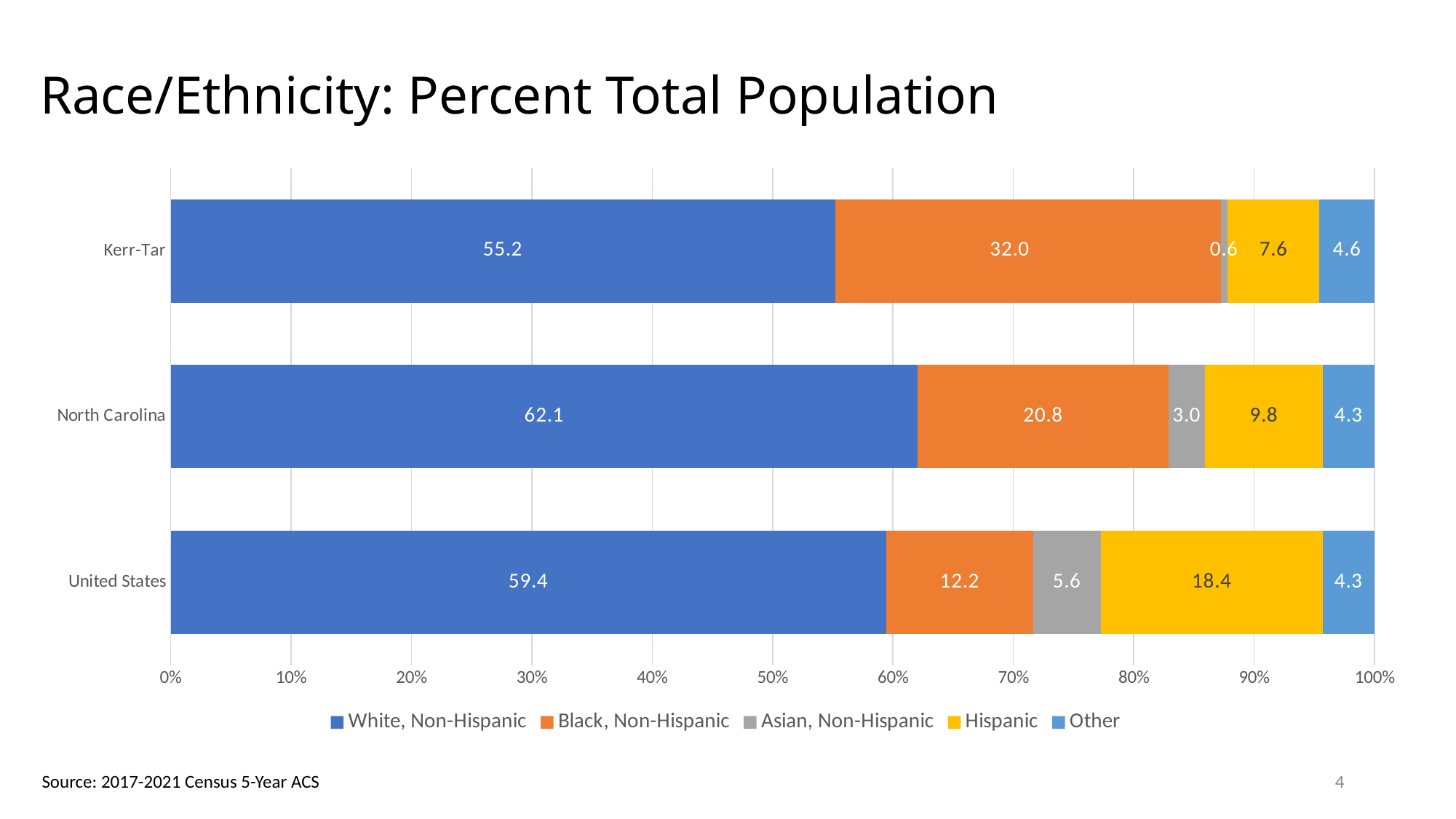
How many regions are shown on the chart? 3 What is the title of the chart? Race/Ethnicity: Percent Total Population What is the difference between the Black, Non-Hispanic values for Kerr-Tar and the United States? 19.8 What is the White, Non-Hispanic value for Kerr-Tar? 55.2 Which region has the lowest Asian, Non-Hispanic value? Kerr-Tar Which region has the highest Black, Non-Hispanic value? Kerr-Tar How many series does the legend list? 5 What is the Hispanic value for the United States? 18.4 What is the total of the stacked bar for North Carolina? 100.0 What kind of chart is shown on the slide? Stacked bar chart What is the Asian, Non-Hispanic value for North Carolina? 3.0 Which is larger, the Hispanic value for North Carolina or for Kerr-Tar? North Carolina